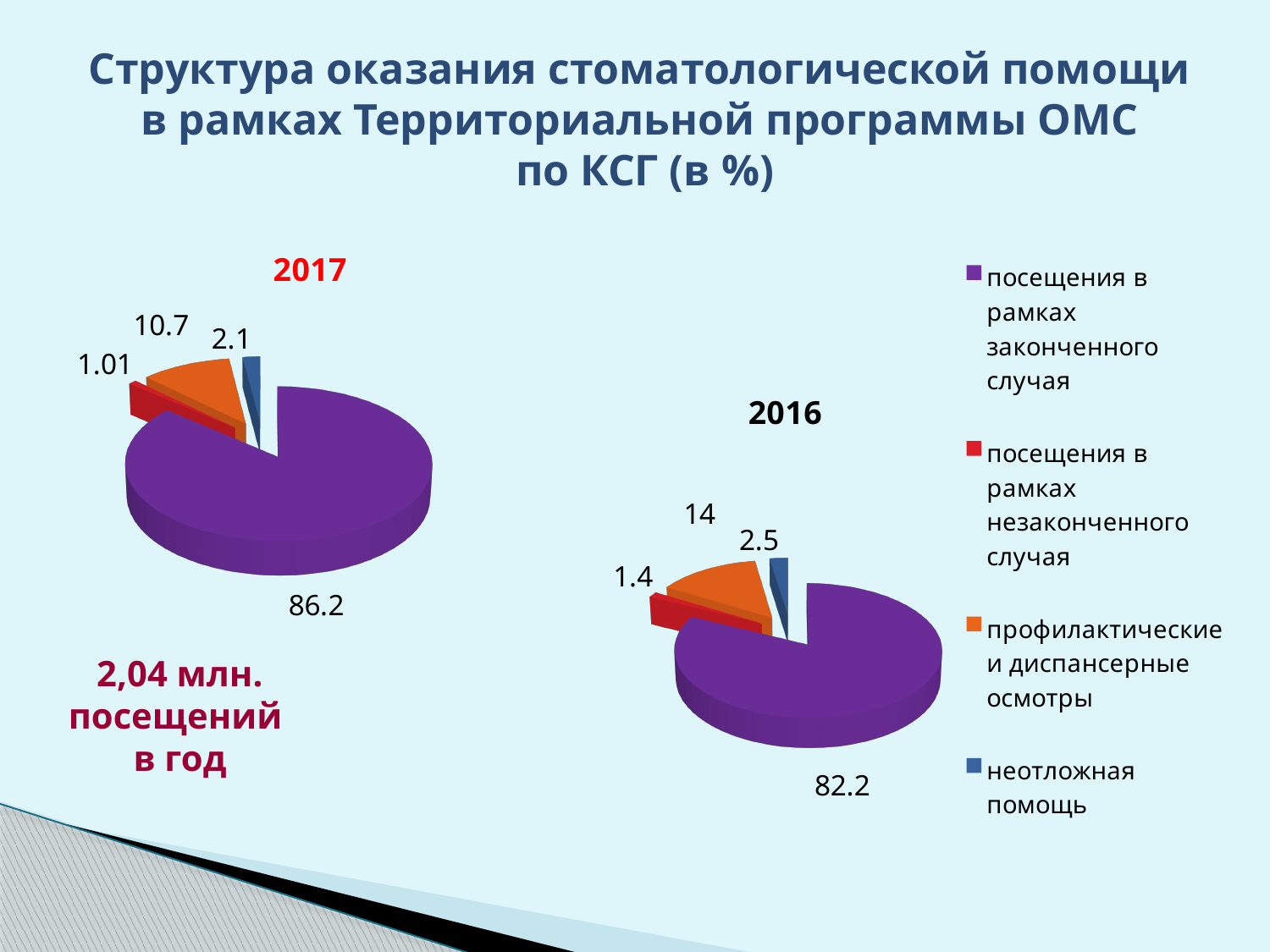
In the 2016 pie chart, which category has the smallest share? посещения в рамках незаконченного случая In the 2016 pie chart, what is the value for профилактические и диспансерные осмотры? 14 In the 2017 pie chart, what is the value for посещения в рамках законченного случая? 86.2 What type of chart is used for the 2017 data? pie chart How many entries does the legend list? 4 In the 2017 pie chart, what is the value for неотложная помощь? 2.1 What colour represents неотложная помощь in the legend? blue In the 2017 pie chart, which category has the largest share? посещения в рамках законченного случая How many slices does the 2016 pie chart have? 4 What is the difference between the value for посещения в рамках законченного случая in the 2017 chart and in the 2016 chart? 4 In the 2016 pie chart, what is the value for посещения в рамках незаконченного случая? 1.4 Which is larger: the value for профилактические и диспансерные осмотры in the 2017 chart or in the 2016 chart? 2016